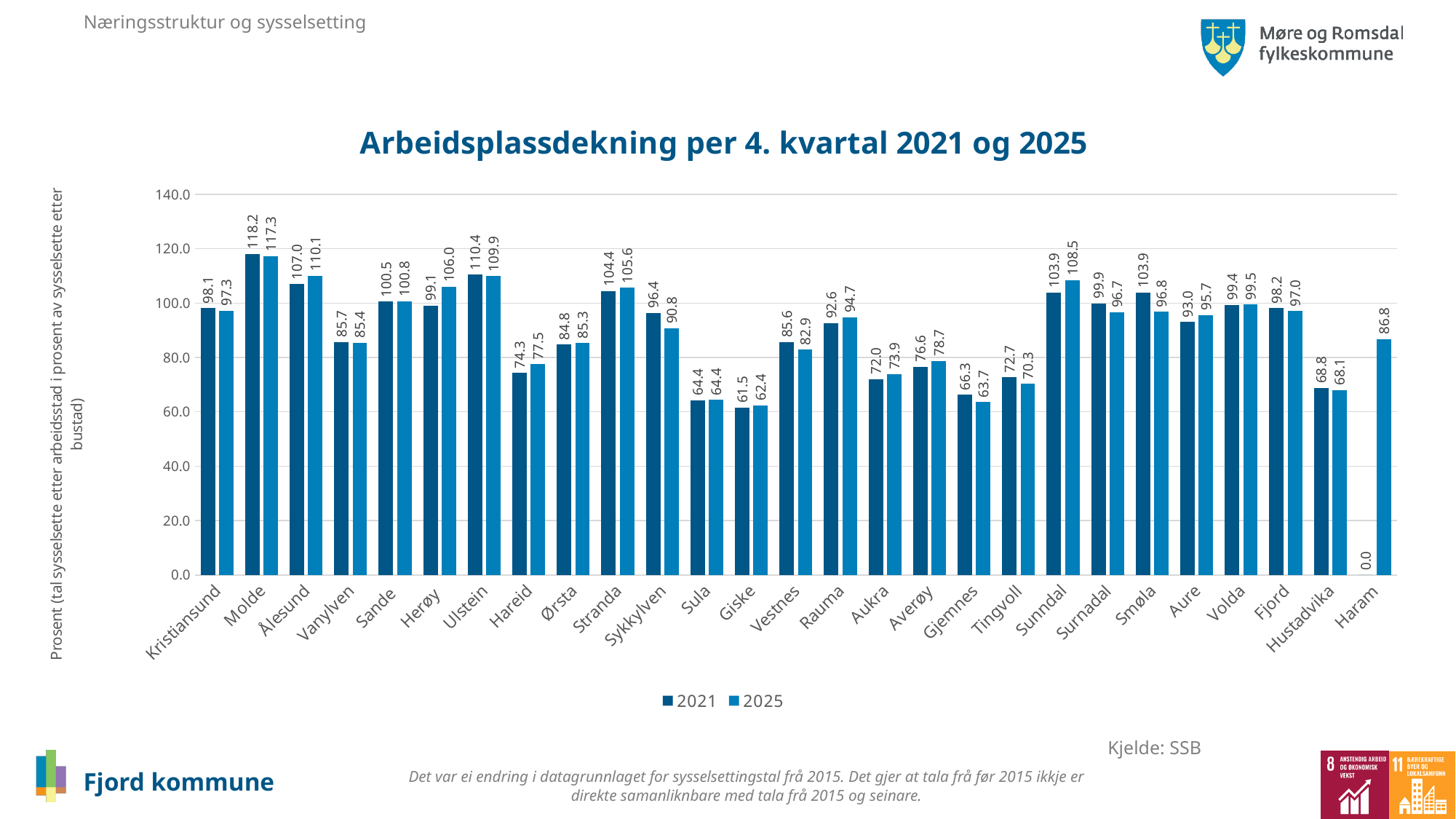
What kind of chart is shown? Bar chart Which municipality has the highest 2025 value? Molde What is the title of the chart? Arbeidsplassdekning per 4. kvartal 2021 og 2025 Which is larger for Ålesund, the 2021 value or the 2025 value? 2025 What is the 2025 value for Herøy? 106.0 How many series does the legend list? 2 What is the difference between the 2021 and 2025 values for Sykkylven? 5.6 How many municipalities are shown on the x axis? 27 Which municipality has the lowest 2025 value? Giske What is the 2021 value for Haram? 0.0 What is the difference between the 2025 and 2021 values for Sunndal? 4.6 What is the 2021 value for Molde? 118.2